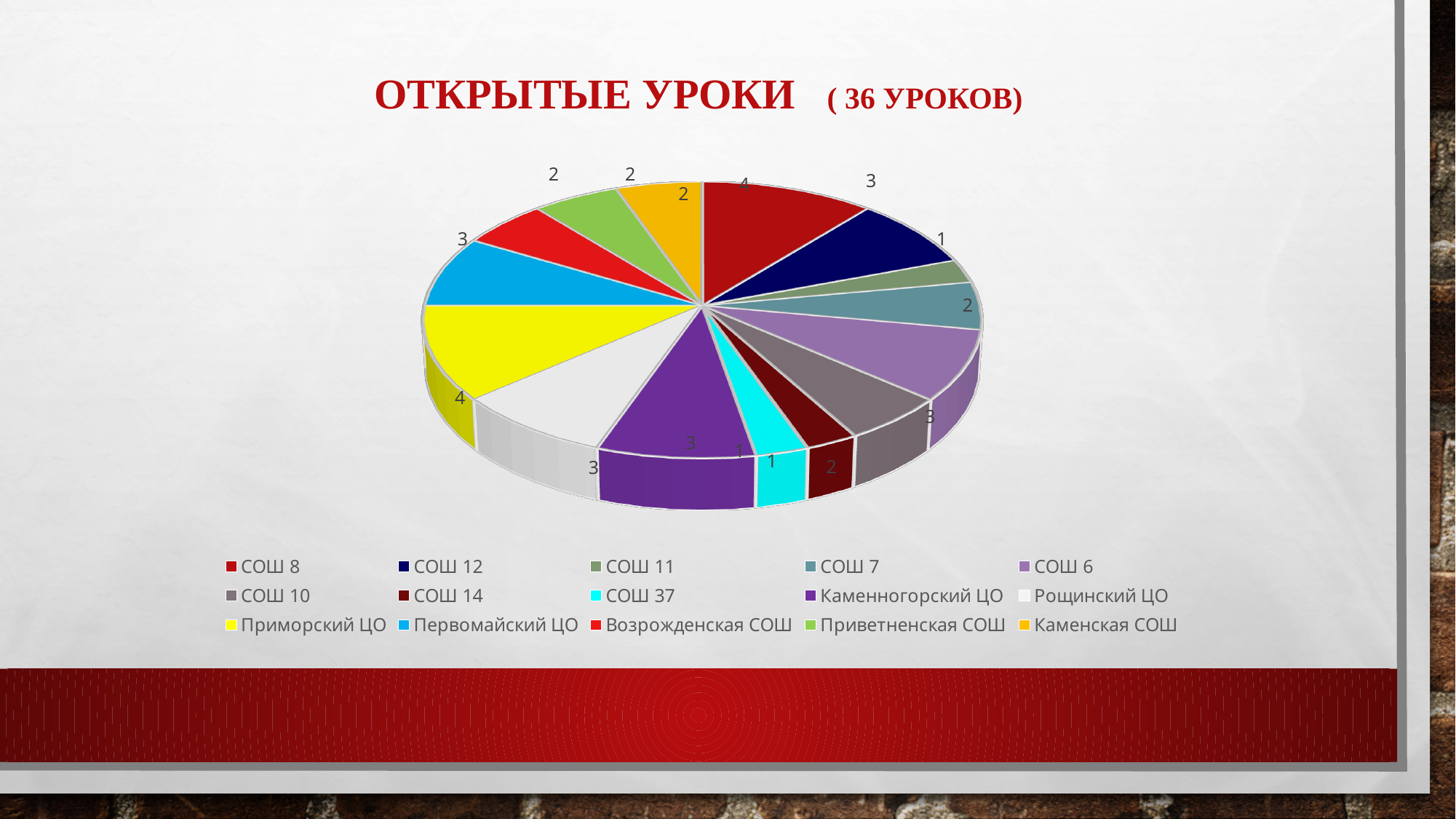
What is the value for СОШ 8? 4 What is the value for СОШ 11? 1 What is the value for Первомайский ЦО? 3 How many categories does the legend list? 15 What type of chart is shown on the slide? Pie chart What is the value for Каменская СОШ? 2 What is the difference between the value for СОШ 8 and the value for СОШ 11? 3 What is the value for СОШ 12? 3 What is the value for Каменногорский ЦО? 3 Which is larger, the value for СОШ 8 or the value for СОШ 12? СОШ 8 What is the value for Приморский ЦО? 4 What is the title of the chart? ОТКРЫТЫЕ УРОКИ (36 УРОКОВ)